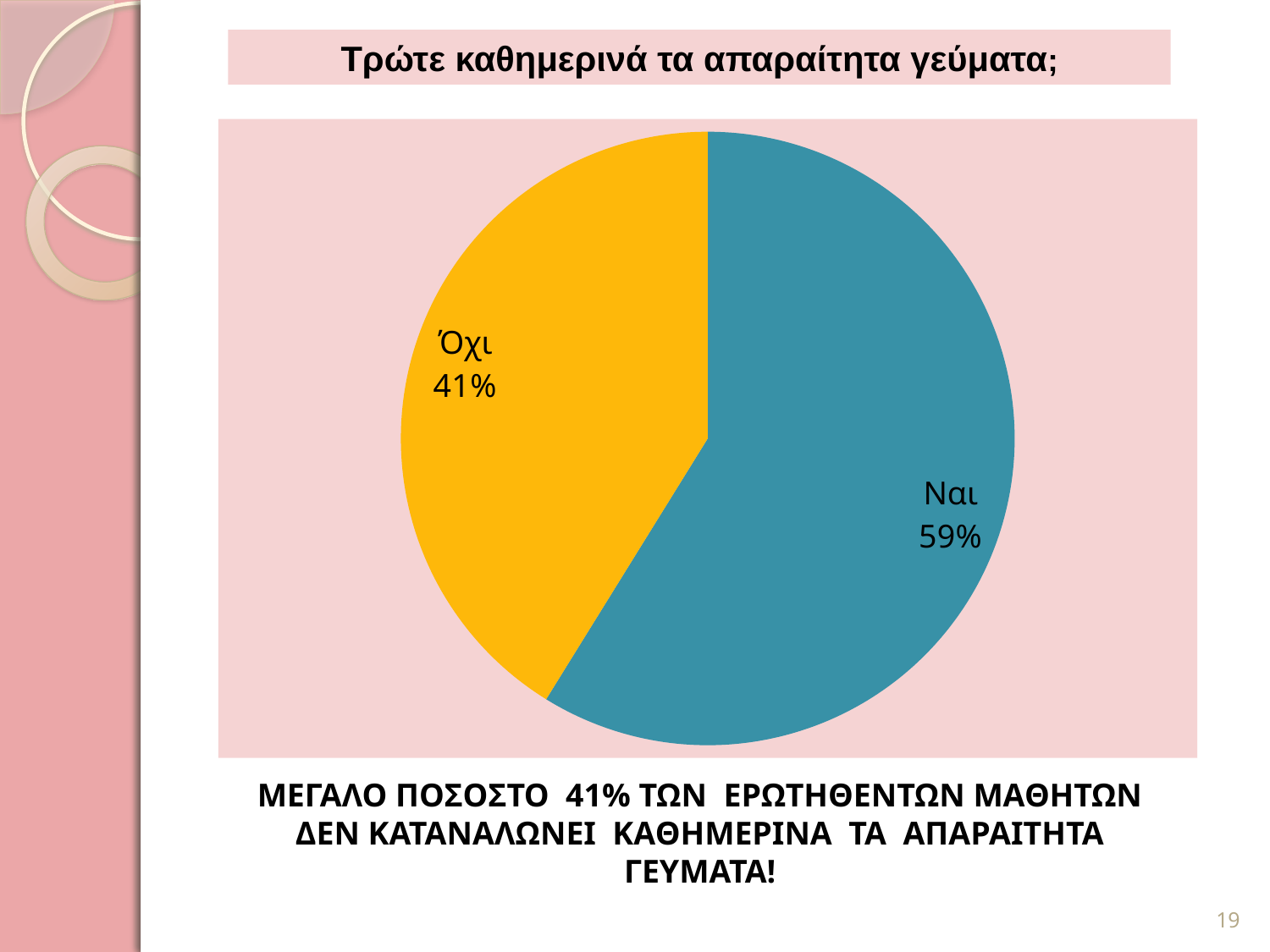
Which is larger, the Ναι slice or the Όχι slice? Ναι What percentage of respondents answered Όχι? 41% How many slices does the pie chart have? 2 What is the title of the chart? Τρώτε καθημερινά τα απαραίτητα γεύματα; Is the value for Ναι greater or less than 50%? greater What share of the pie does the Όχι slice represent? 41% Which slice of the pie is the smallest? Όχι What kind of chart is shown on the slide? pie chart What colour is the Ναι slice? teal blue What is the difference in percentage points between the Ναι and Όχι slices? 18 What percentage of respondents answered Ναι? 59% Which slice of the pie is the largest? Ναι